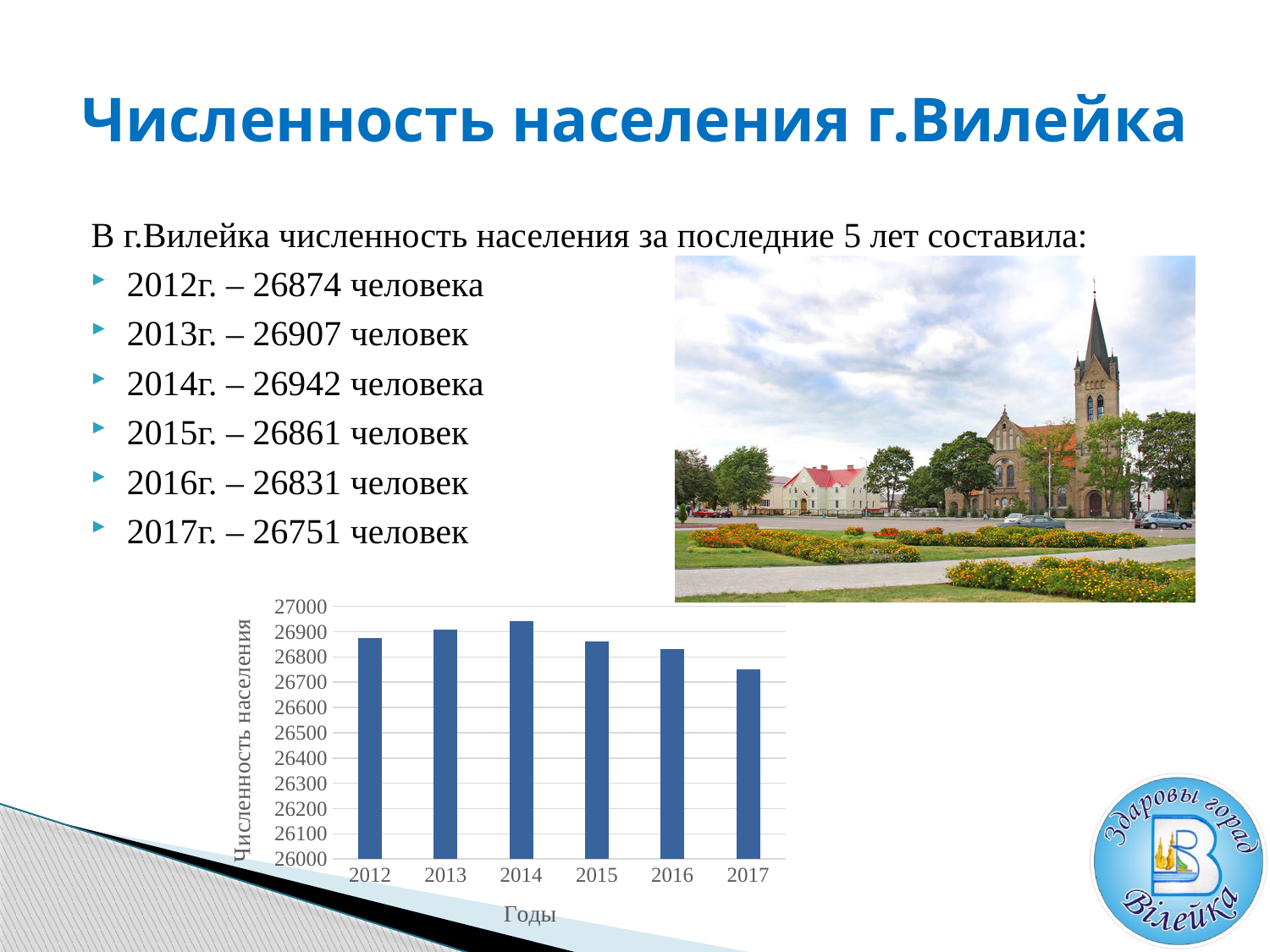
What is the population value for 2017? 26751 Is the value for 2014 greater or less than 26900? greater Which year has the lowest population in the chart? 2017 What is the difference between the population in 2012 and in 2017? 123 What is the population value for 2014? 26942 Which is larger, the population in 2013 or in 2016? 2013 Is the value for 2017 greater or less than 26800? less How many years (bars) are shown in the chart? 6 Which year has the highest population in the chart? 2014 What kind of chart is shown on the slide? bar chart What is the label of the horizontal axis of the chart? Годы Does the population rise or fall from 2014 to 2017? fall